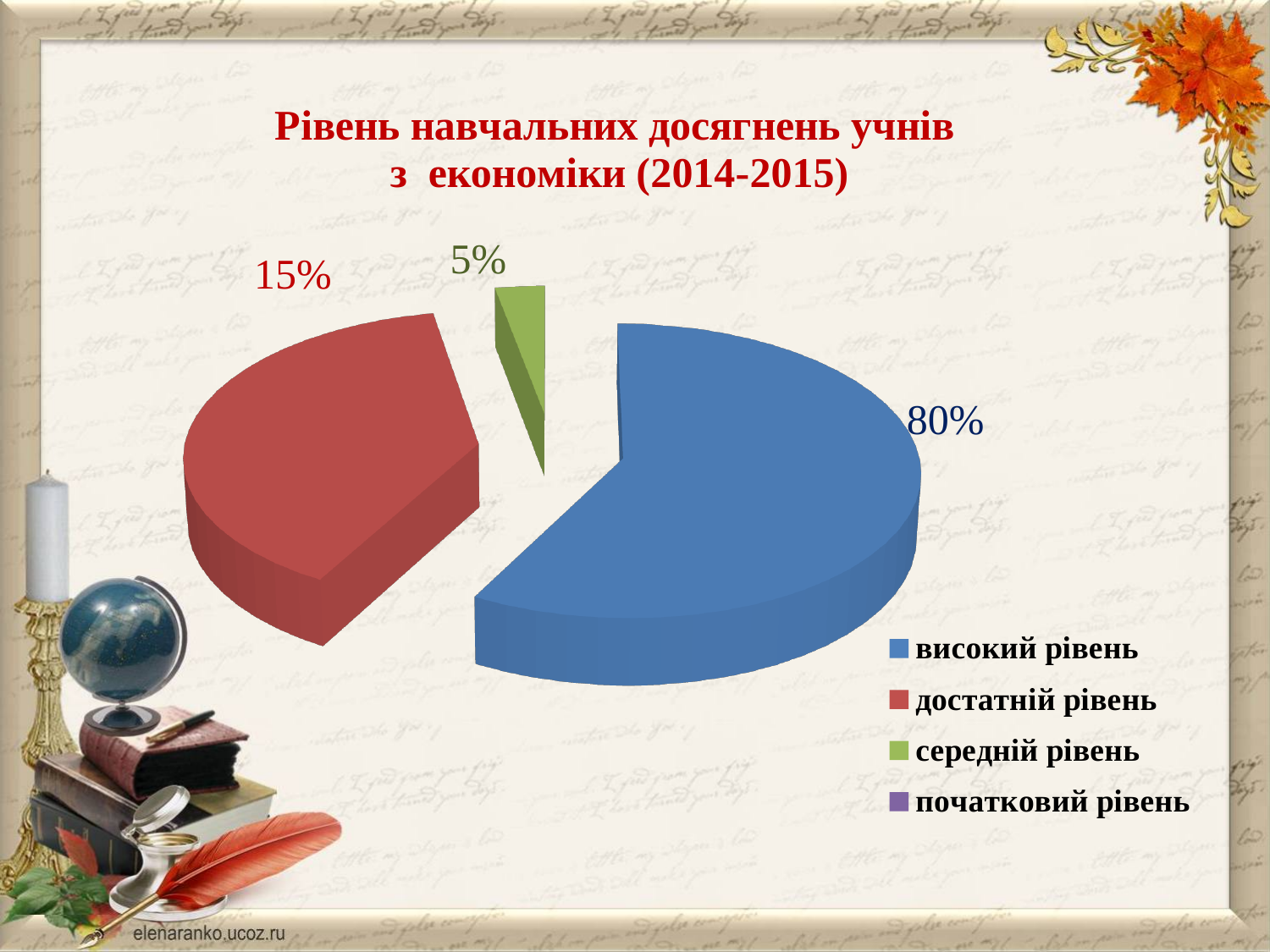
What share of the pie does the blue slice represent? 80% What percentage of students are at the середній рівень? 5% Which is larger, the share for достатній рівень or the share for середній рівень? достатній рівень Which level has the largest slice of the pie? високий рівень What colour is used for достатній рівень in the chart? red What percentage of students are at the високий рівень? 80% What is the difference in percentage points between високий рівень and достатній рівень? 65 How many slices have a percentage label printed on the chart? 3 Which of the labelled slices is the smallest? середній рівень What kind of chart is shown on the slide? pie chart How many entries does the legend list? 4 What percentage of students are at the достатній рівень? 15%